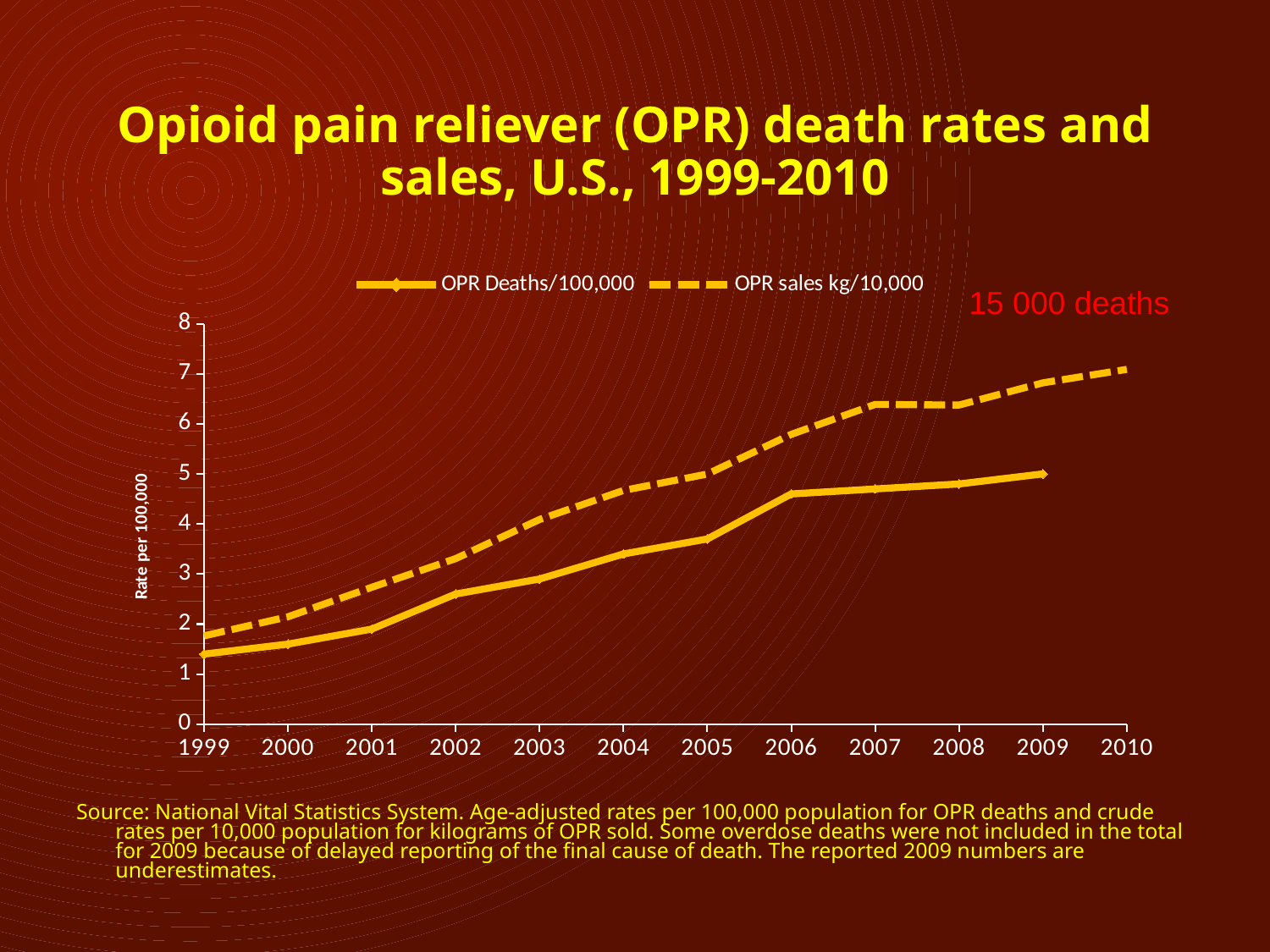
Is the value for OPR Deaths/100,000 in 1999 greater or less than 2? less Is the value for OPR sales kg/10,000 in 2003 greater or less than 3? greater How many series does the legend list? 2 Is the value for OPR Deaths/100,000 in 2006 greater or less than 4? greater Does the OPR sales kg/10,000 series rise or fall from 1999 to 2010? rise What kind of chart is shown on the slide? line chart How many years are shown along the x axis? 12 Which series is drawn with a dashed line? OPR sales kg/10,000 In 2005, which series has the higher value, OPR Deaths/100,000 or OPR sales kg/10,000? OPR sales kg/10,000 Does the OPR Deaths/100,000 series rise or fall from 1999 to 2009? rise